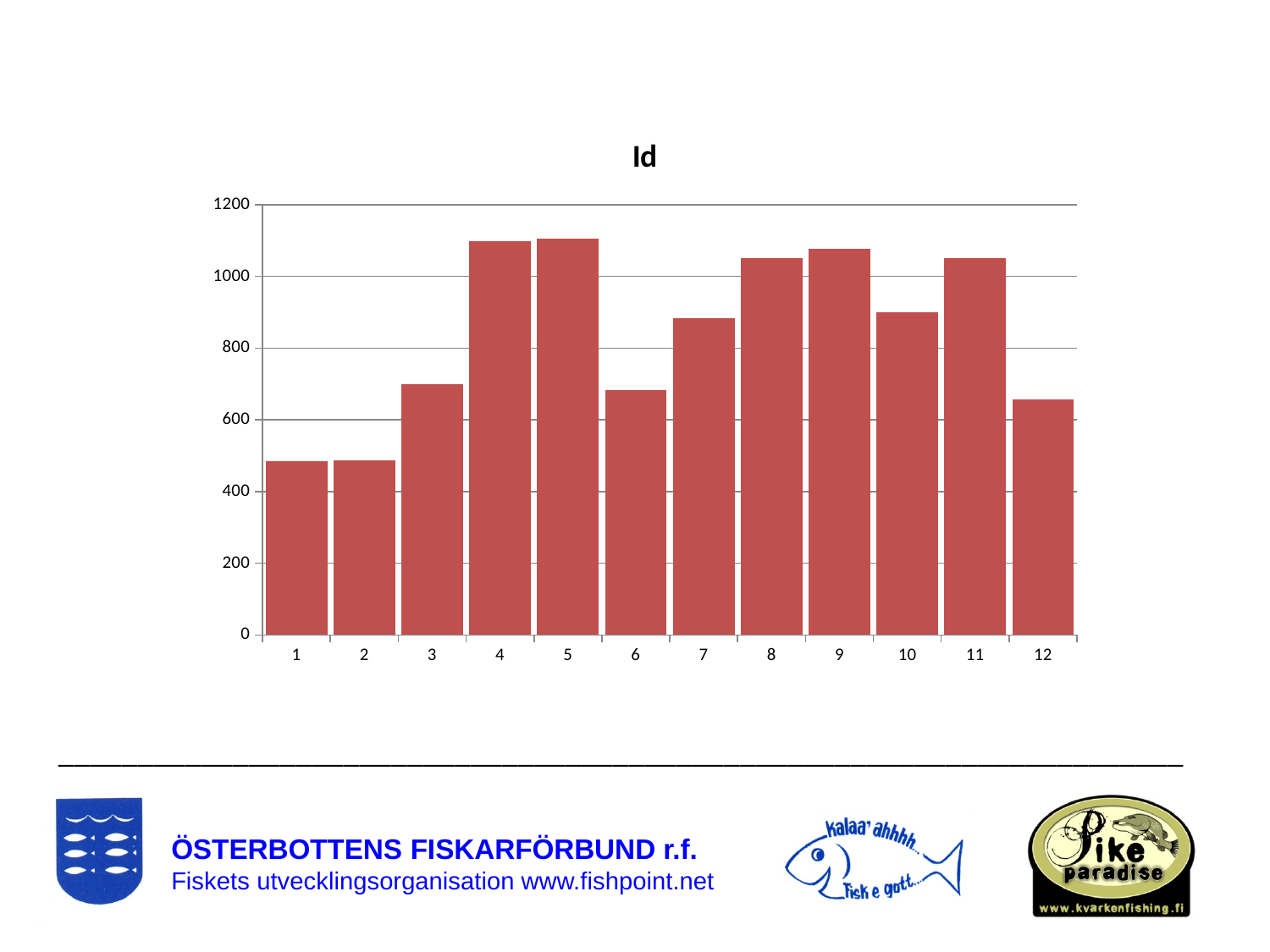
Which has the larger value, category 12 or category 9? 9 What kind of chart is shown on the slide? bar chart Is the value for category 4 greater or less than 1000? greater Which has the larger value, category 4 or category 6? 4 Is the value for category 12 greater or less than 800? less Is the value for category 7 greater or less than 800? greater Do the values rise or fall from category 1 to category 4? rise What colour are the bars in the chart? red How many categories are shown on the x axis of the chart? 12 What is the title of the chart? Id